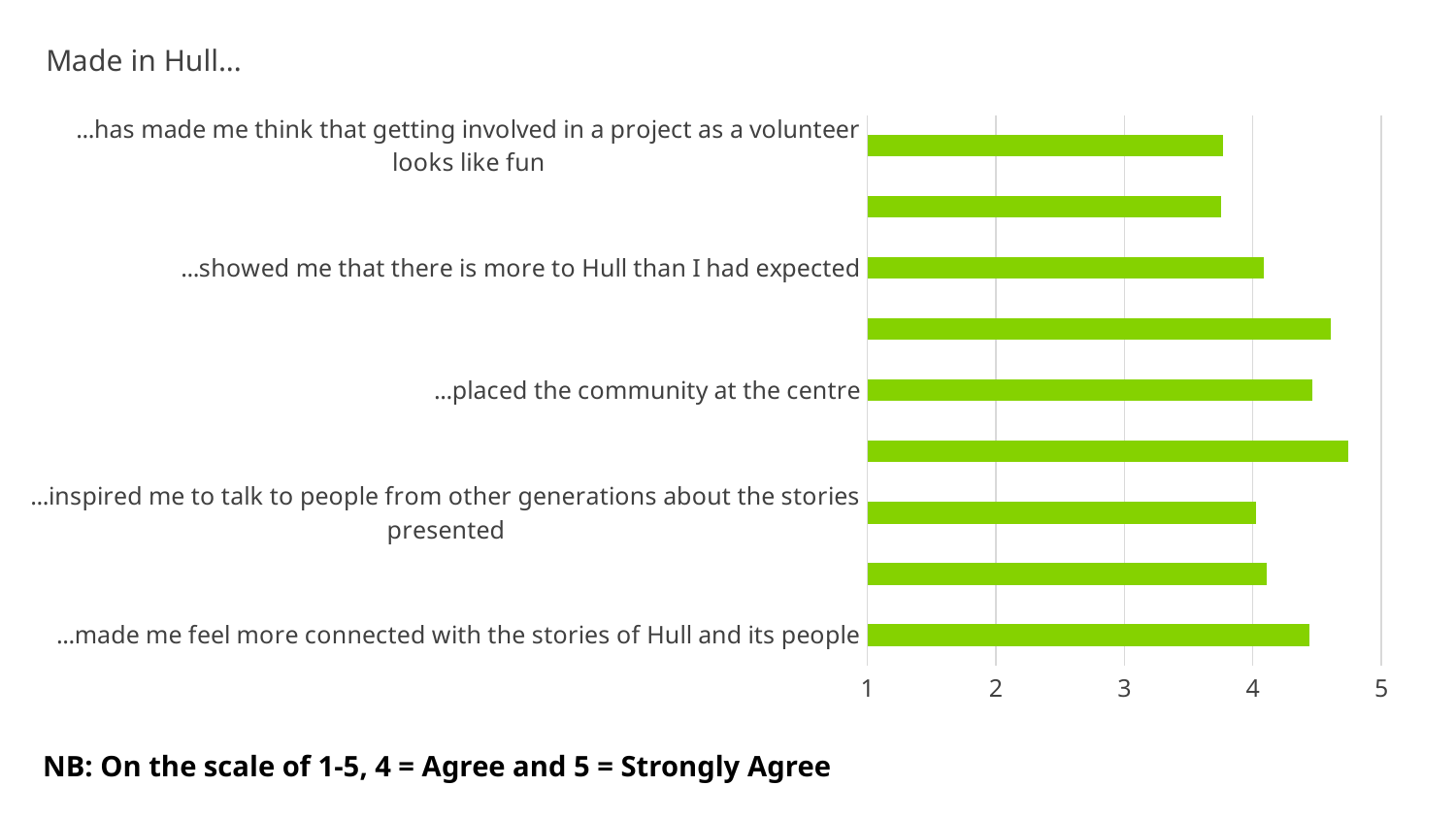
Is the value for "...has made me think that getting involved in a project as a volunteer looks like fun" greater or less than 3? greater What colour are the bars in the chart? green Which has the larger value: "...placed the community at the centre" or "...has made me think that getting involved in a project as a volunteer looks like fun"? ...placed the community at the centre Is the value for "...placed the community at the centre" greater or less than 4? greater Is the value for "...made me feel more connected with the stories of Hull and its people" greater or less than 4? greater How many bars are plotted in the chart? 9 Which has the larger value: "...made me feel more connected with the stories of Hull and its people" or "...showed me that there is more to Hull than I had expected"? ...made me feel more connected with the stories of Hull and its people What kind of chart is shown on the slide? bar chart What is the highest value shown on the horizontal axis? 5 What is the title of the chart? Made in Hull...